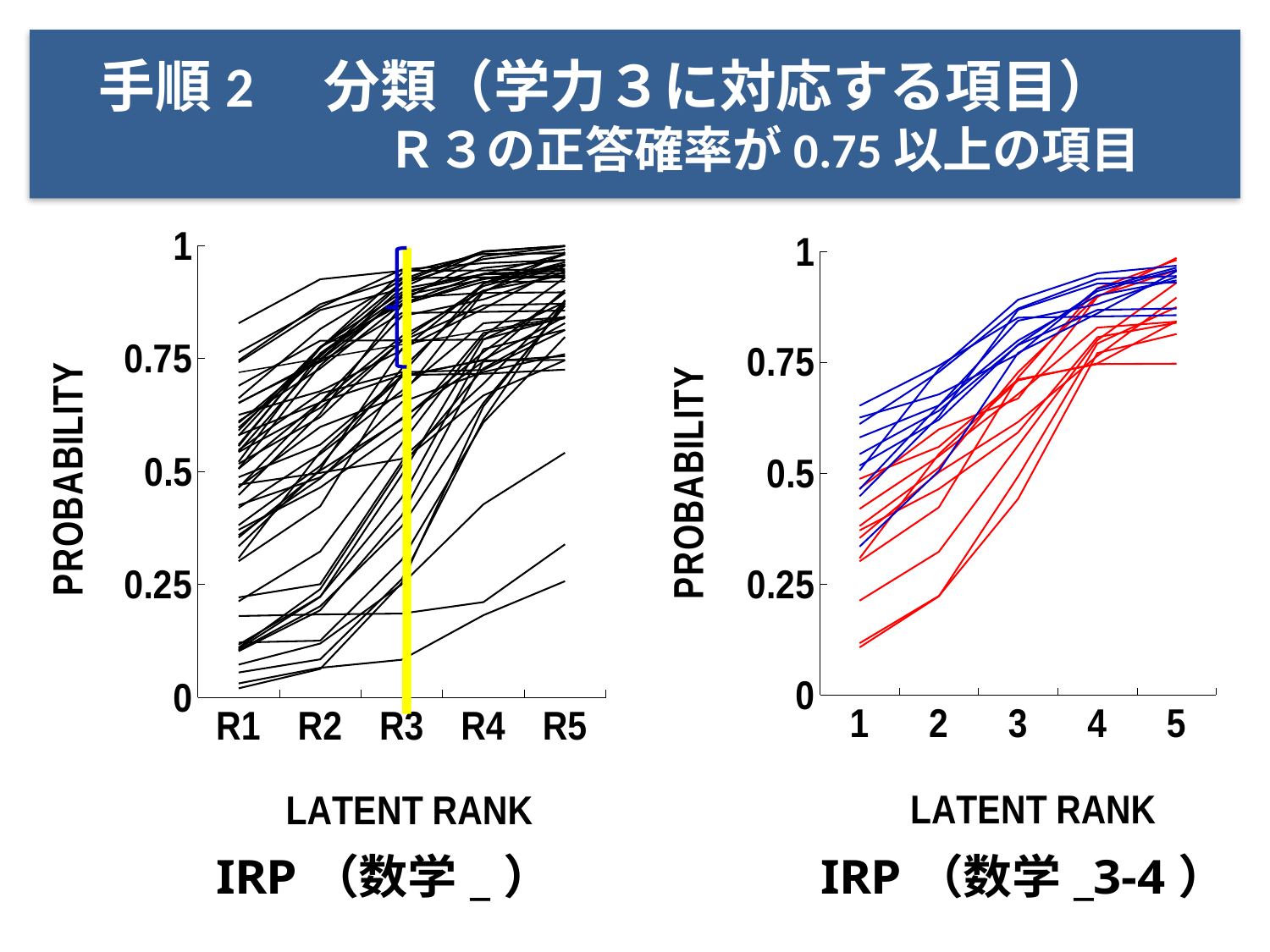
In the right chart, do the lines generally rise or fall from latent rank 1 to 5? rise In the left chart, do the lines generally rise or fall from R1 to R5? rise In the left chart, how many latent rank categories are shown on the x axis? 5 What kind of chart is the left chart titled IRP（数学_）? line chart What is the y-axis label of the left chart? PROBABILITY In the right chart, what two colours are used for the lines? blue and red What is the x-axis label of the right chart? LATENT RANK What kind of chart is the right chart titled IRP（数学_3-4）? line chart In the right chart, how many latent rank values are shown on the x axis? 5